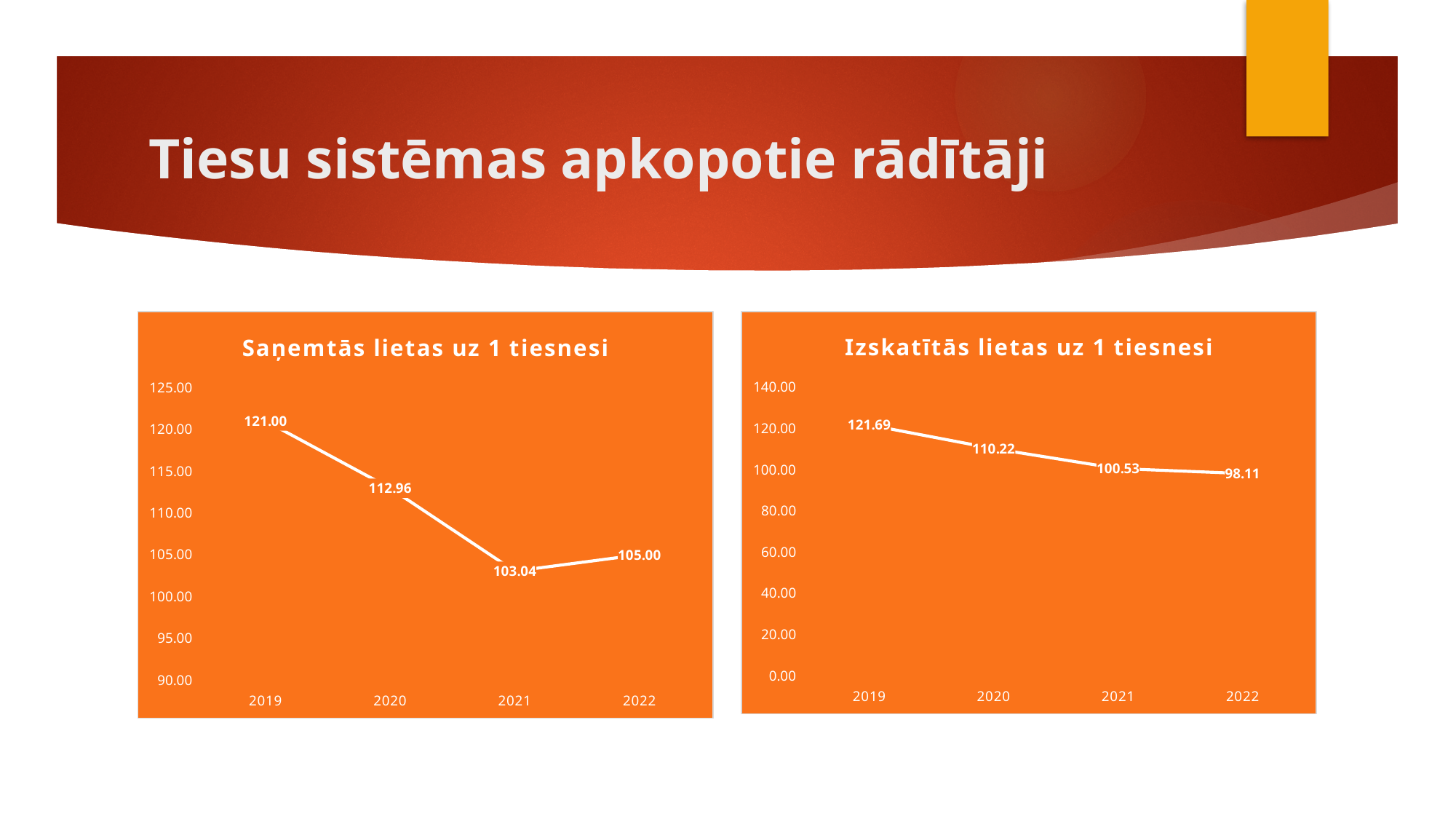
In the chart titled 'Izskatītās lietas uz 1 tiesnesi', which year has the highest value? 2019 In the chart titled 'Izskatītās lietas uz 1 tiesnesi', do the values rise or fall from 2019 to 2022? fall In the chart titled 'Izskatītās lietas uz 1 tiesnesi', what is the value for 2022? 98.11 In the chart titled 'Saņemtās lietas uz 1 tiesnesi', what is the difference between the 2019 value and the 2022 value? 16.00 In the chart titled 'Saņemtās lietas uz 1 tiesnesi', which year has the lowest value? 2021 How many years are plotted in the chart titled 'Saņemtās lietas uz 1 tiesnesi'? 4 What kind of chart is the chart titled 'Izskatītās lietas uz 1 tiesnesi'? line chart In the chart titled 'Izskatītās lietas uz 1 tiesnesi', what is the difference between the 2020 value and the 2021 value? 9.69 In the chart titled 'Saņemtās lietas uz 1 tiesnesi', what is the value for 2020? 112.96 In the chart titled 'Saņemtās lietas uz 1 tiesnesi', which is larger, the value for 2021 or the value for 2022? 2022 What is the title of the chart on the left side of the slide? Saņemtās lietas uz 1 tiesnesi In the chart titled 'Izskatītās lietas uz 1 tiesnesi', is the value for 2021 greater or less than 100.00? greater